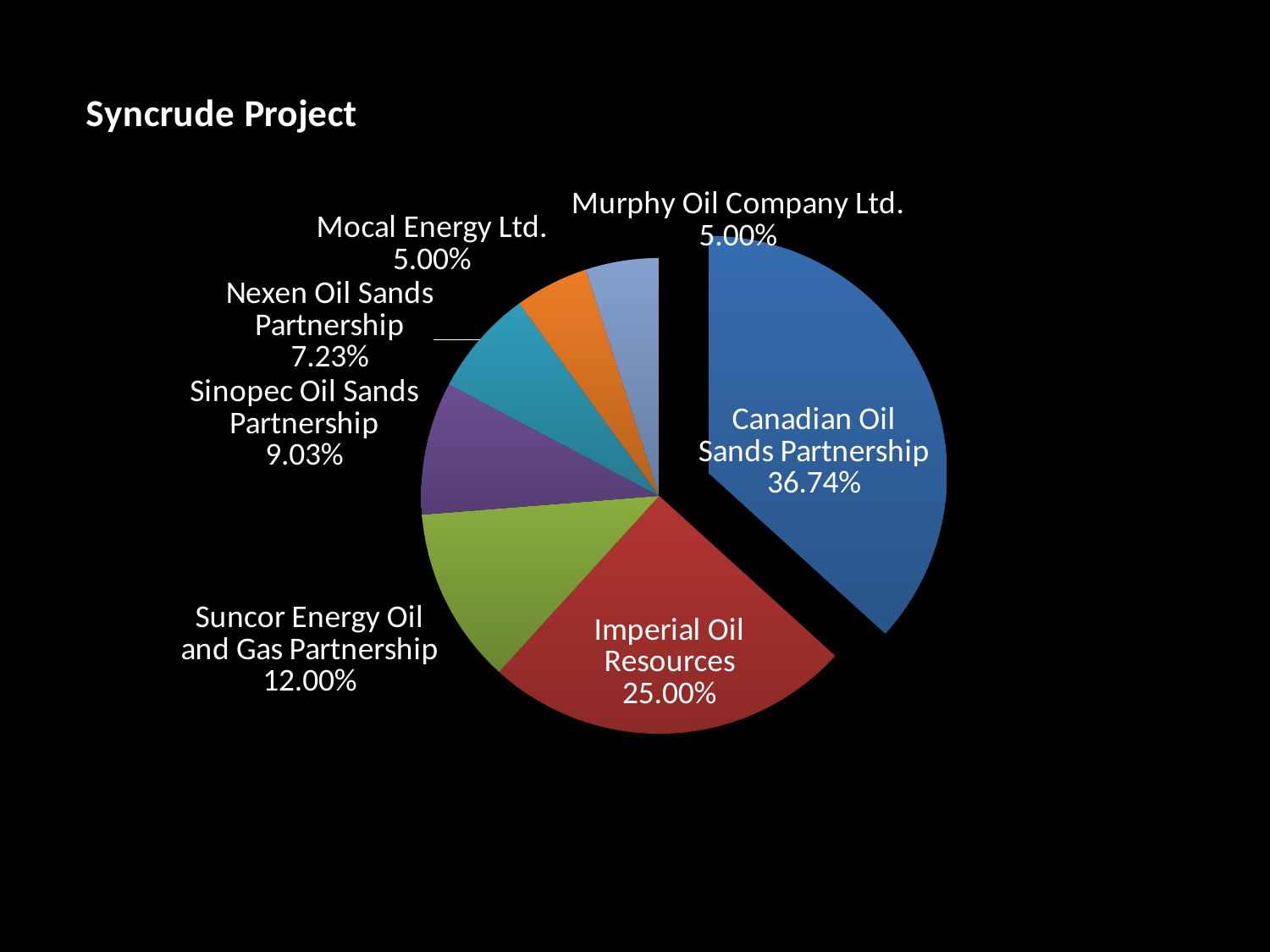
What is the title of the chart? Syncrude Project Which partner has the largest slice of the pie chart? Canadian Oil Sands Partnership What percentage does Sinopec Oil Sands Partnership hold? 9.03% How much larger is Suncor Energy Oil and Gas Partnership's share than Sinopec Oil Sands Partnership's? 2.97% How many slices does the pie chart have? 7 What share of the Syncrude Project pie chart does Canadian Oil Sands Partnership hold? 36.74% What percentage is shown for Imperial Oil Resources? 25.00% What type of chart is shown on the slide? Pie chart What is the value labelled for Suncor Energy Oil and Gas Partnership? 12.00% Which has a larger share, Nexen Oil Sands Partnership or Sinopec Oil Sands Partnership? Sinopec Oil Sands Partnership What is the share shown for Nexen Oil Sands Partnership? 7.23% What is the difference between the shares of Canadian Oil Sands Partnership and Imperial Oil Resources? 11.74%